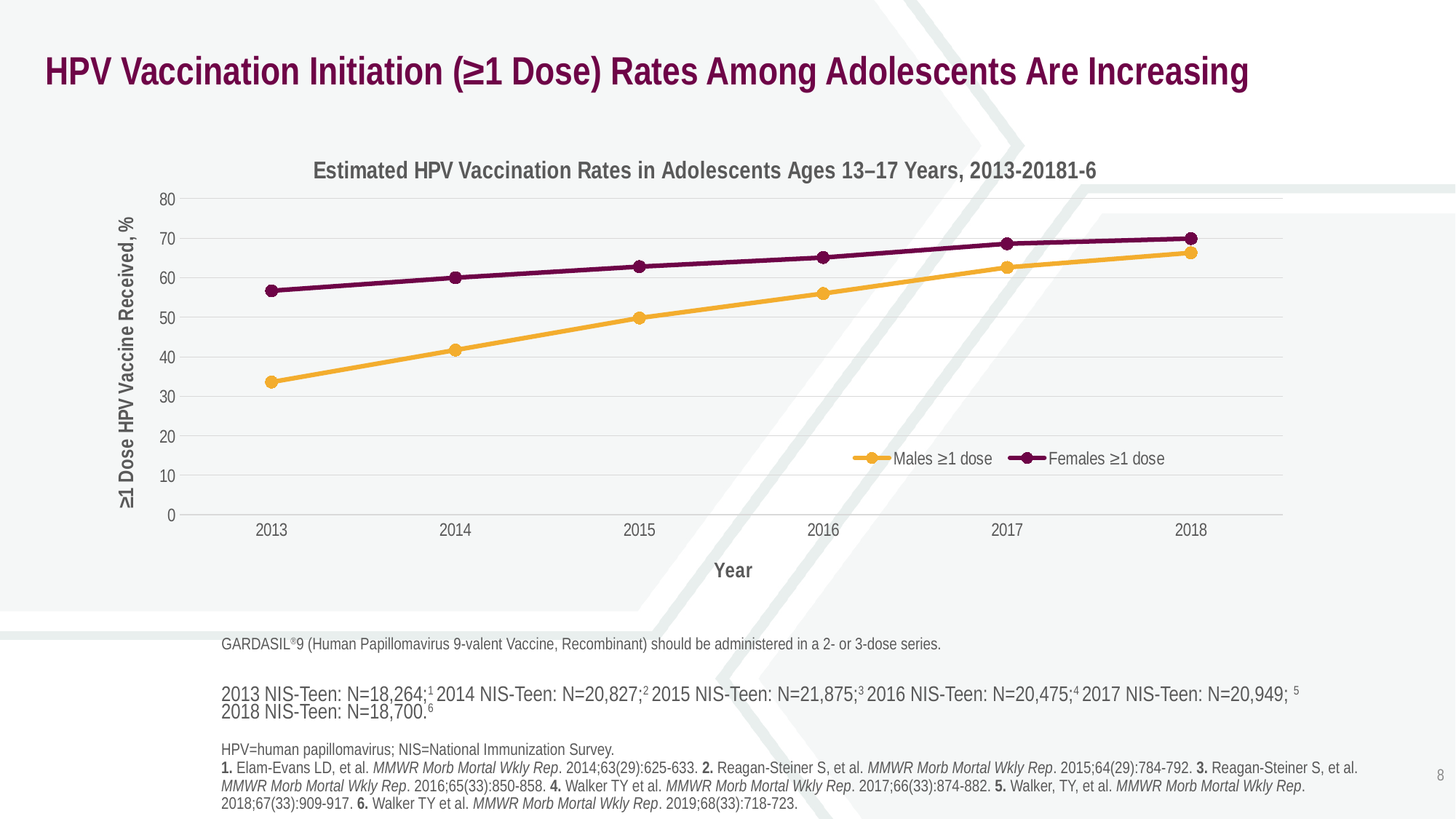
Is the value for Females ≥1 dose in 2013 greater or less than 50? greater In which year is the value for Males ≥1 dose lowest? 2013 How many years are plotted along the x axis? 6 Is the value for Males ≥1 dose in 2016 greater or less than 50? greater What is the label of the y axis of the chart? ≥1 Dose HPV Vaccine Received, % Do the values for Males ≥1 dose rise or fall from 2013 to 2018? Rise What kind of chart is shown on the slide? Line chart Is the value for Males ≥1 dose in 2018 greater or less than 70? less In which year is the value for Females ≥1 dose highest? 2018 In 2013, which series has the larger value, Males ≥1 dose or Females ≥1 dose? Females ≥1 dose How many series does the legend list? 2